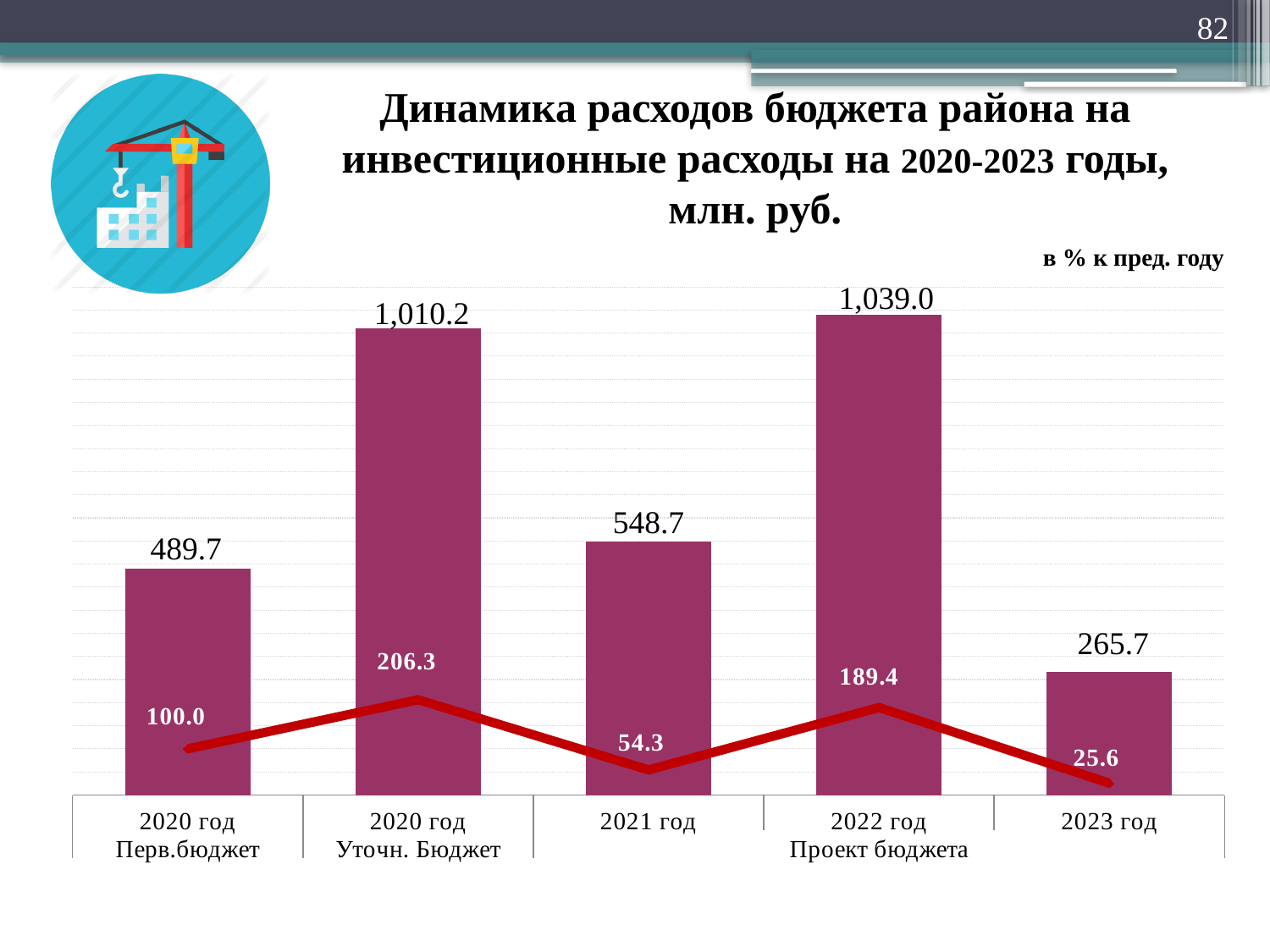
What is the difference between the bar values for 2022 год and 2021 год? 490.3 What is the difference between the line values for 2020 год Уточн. Бюджет and 2023 год? 180.7 What is the percentage to the previous year (в % к пред. году) shown on the line for 2022 год? 189.4 How many categories are shown on the x axis? 5 What is the value shown for 2020 год Уточн. Бюджет? 1,010.2 What is the percentage to the previous year shown on the line for 2021 год? 54.3 What is the value shown for 2023 год? 265.7 Which category has the lowest bar value? 2023 год What is the budget investment expenditure value (million rubles) for 2021 год? 548.7 What kind of chart is this? Bar chart with a line Which is larger: the bar value for 2020 год Перв.бюджет or for 2021 год? 2021 год Which category has the highest bar value? 2022 год